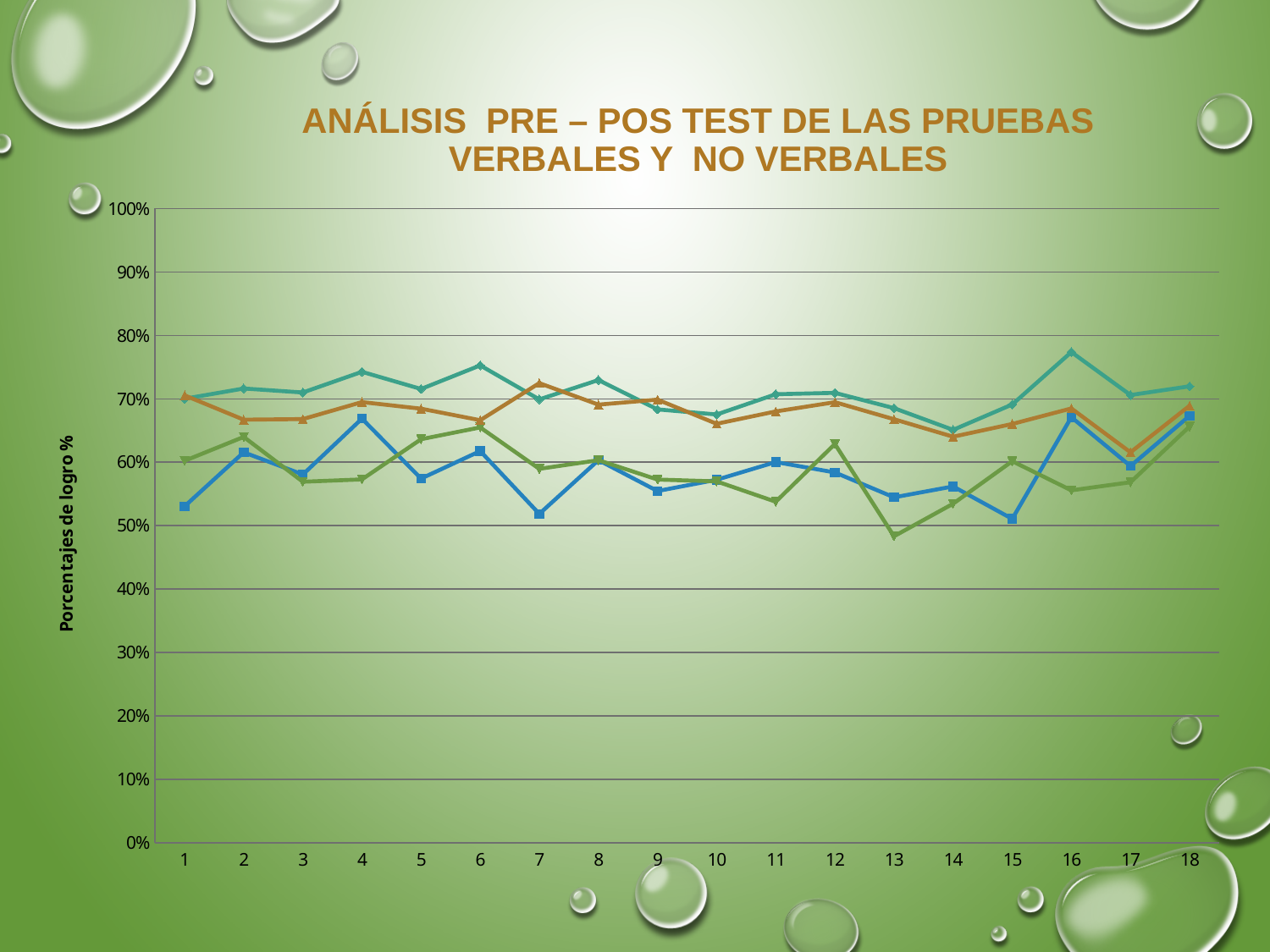
What is the label of the vertical axis of the chart? Porcentajes de logro % Is the value of the green line at category 13 greater or less than 50%? less Is the value of the blue line at category 1 greater or less than 60%? less What is the title of the chart on the slide? ANÁLISIS PRE – POS TEST DE LAS PRUEBAS VERBALES Y NO VERBALES Is the value of the orange line at category 14 greater or less than 70%? less At category 1, which line has the larger value, the blue line or the teal line? the teal line At which category does the teal line reach its highest value? 16 How many lines are plotted on the chart? 4 At which category does the green line reach its lowest value? 13 How many categories are shown on the x axis of the chart? 18 What kind of chart is shown on the slide? line chart